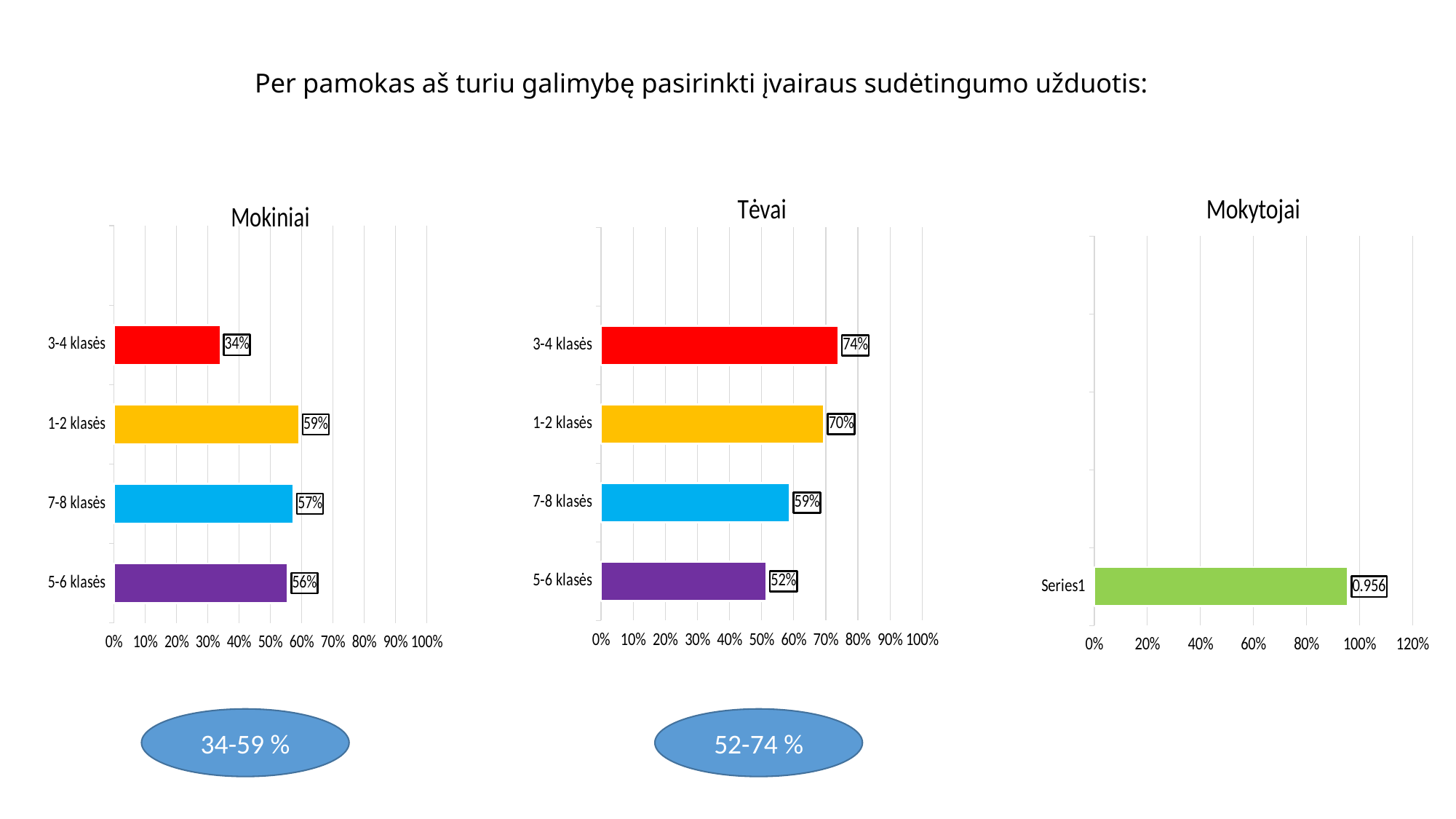
In the Tėvai chart, which category has the lowest value? 5-6 klasės What kind of chart is the Mokiniai chart? Bar chart In the Mokiniai chart, which category has the lowest value? 3-4 klasės In the Mokiniai chart, what is the difference between the values for 1-2 klasės and 3-4 klasės? 25% In the Mokiniai chart, what is the value for 3-4 klasės? 34% In the Tėvai chart, what is the difference between the values for 3-4 klasės and 5-6 klasės? 22% In the Mokytojai chart, what is the value for Series1? 0.956 In the Tėvai chart, which category has the highest value? 3-4 klasės How many categories does the Tėvai chart show? 4 Which is larger: the value for 1-2 klasės in the Mokiniai chart or the value for 1-2 klasės in the Tėvai chart? Tėvai In the Mokiniai chart, which category has the highest value? 1-2 klasės In the Tėvai chart, what is the value for 7-8 klasės? 59%